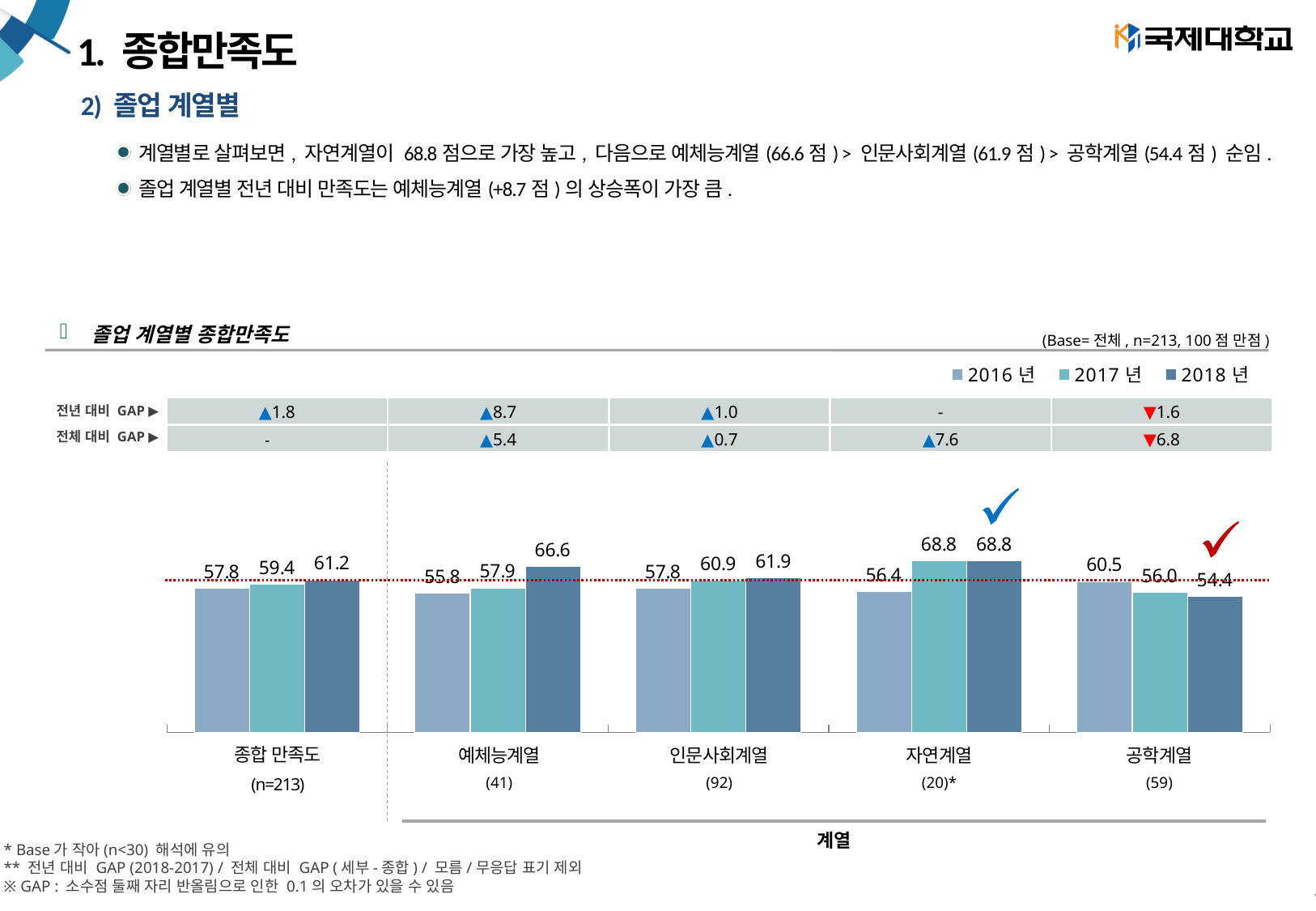
What is the 2018년 value for 자연계열? 68.8 Do the values for 종합 만족도 rise or fall from 2016년 to 2018년? rise What is the 2017년 value for 인문사회계열? 60.9 Which category has the highest 2018년 value? 자연계열 Which is larger for 공학계열: the 2016년 value or the 2018년 value? 2016년 What is the 2018년 value for 공학계열? 54.4 What is the 2016년 value for 예체능계열? 55.8 How many series does the legend list? 3 Which category has the lowest 2018년 value? 공학계열 What is the difference between the 2018년 and 2017년 values for 예체능계열? 8.7 How many categories are shown on the x axis? 5 What kind of chart is shown? bar chart